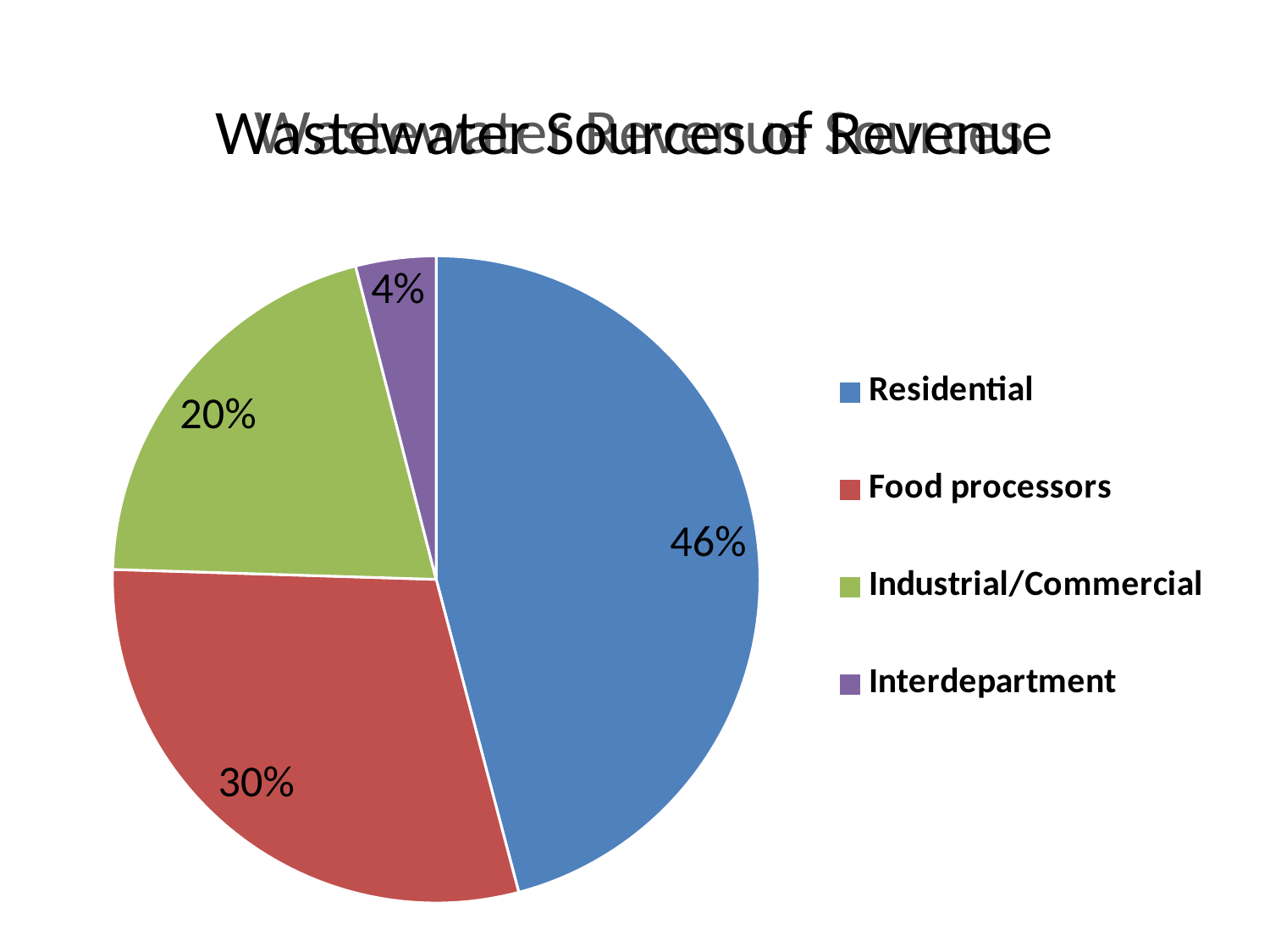
What is the difference in percentage points between the Industrial/Commercial and Interdepartment slices? 16 What share of the pie does Food processors account for? 30% What share of the pie does Residential account for? 46% What is the difference in percentage points between the Residential and Food processors slices? 16 What kind of chart is shown on the slide? Pie chart What colour is the Industrial/Commercial slice? Green What share of the pie does Industrial/Commercial account for? 20% Which is larger, the Food processors slice or the Industrial/Commercial slice? Food processors Which category has the smallest slice of the pie? Interdepartment How many categories are shown in the pie chart? 4 Which category has the largest slice of the pie? Residential